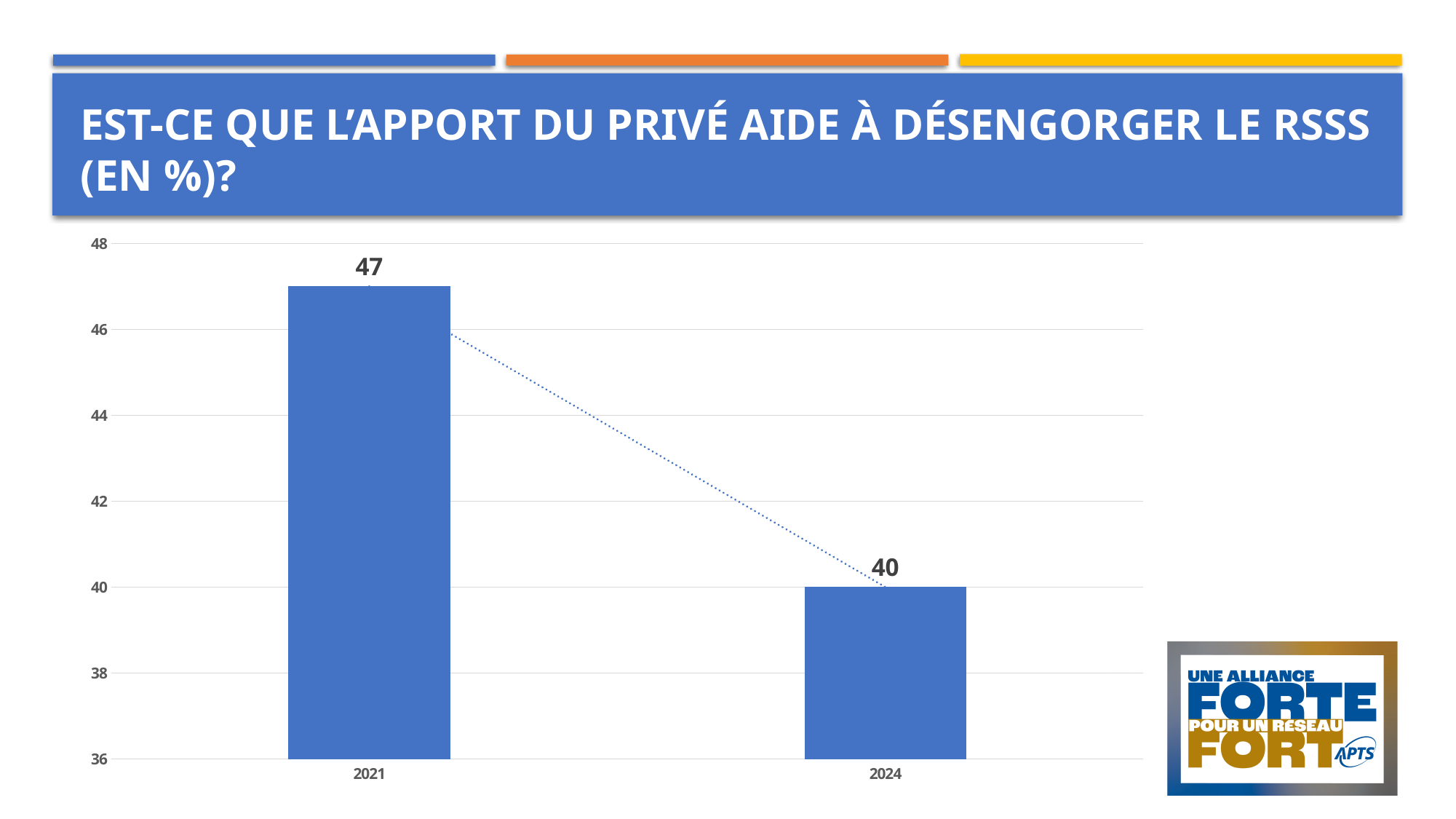
Is the value for 2021 greater or less than 46? greater Do the values rise or fall from 2021 to 2024? fall What is the difference between the values for 2021 and 2024? 7 What kind of chart is shown on the slide? bar chart Which year has the lowest value? 2024 Which is larger, the value for 2021 or the value for 2024? 2021 How many categories are shown on the x axis? 2 Is the value for 2024 greater or less than 42? less What is the value for 2024? 40 What is the value for 2021? 47 Which year has the highest value? 2021 What is the title of the slide containing the chart? EST-CE QUE L'APPORT DU PRIVÉ AIDE À DÉSENGORGER LE RSSS (EN %)?